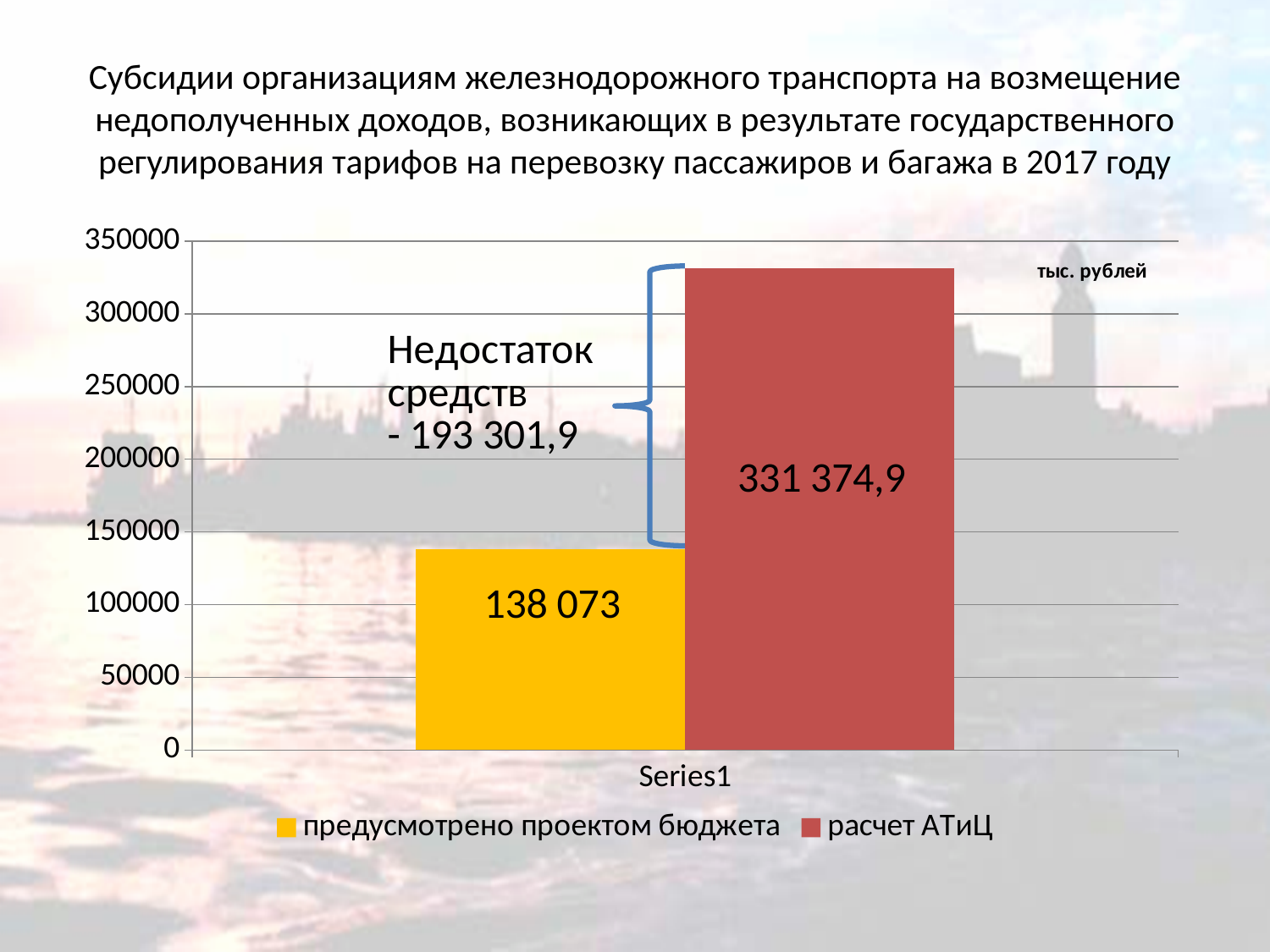
What unit of measurement is indicated on the chart? тыс. рублей How many series does the legend list? 2 What is the value for the series "расчет АТиЦ"? 331 374,9 Which series has the lowest value on the chart? предусмотрено проектом бюджета What kind of chart is shown on the slide? bar chart What is the difference between the value for "расчет АТиЦ" and the value for "предусмотрено проектом бюджета"? 193 301,9 Is the value for "расчет АТиЦ" greater or less than 300000? greater Which series has the higher value, "предусмотрено проектом бюджета" or "расчет АТиЦ"? расчет АТиЦ What colour is the bar for "расчет АТиЦ"? red Which series has the highest value on the chart? расчет АТиЦ Is the value for "предусмотрено проектом бюджета" greater or less than 150000? less What is the value for the series "предусмотрено проектом бюджета"? 138 073